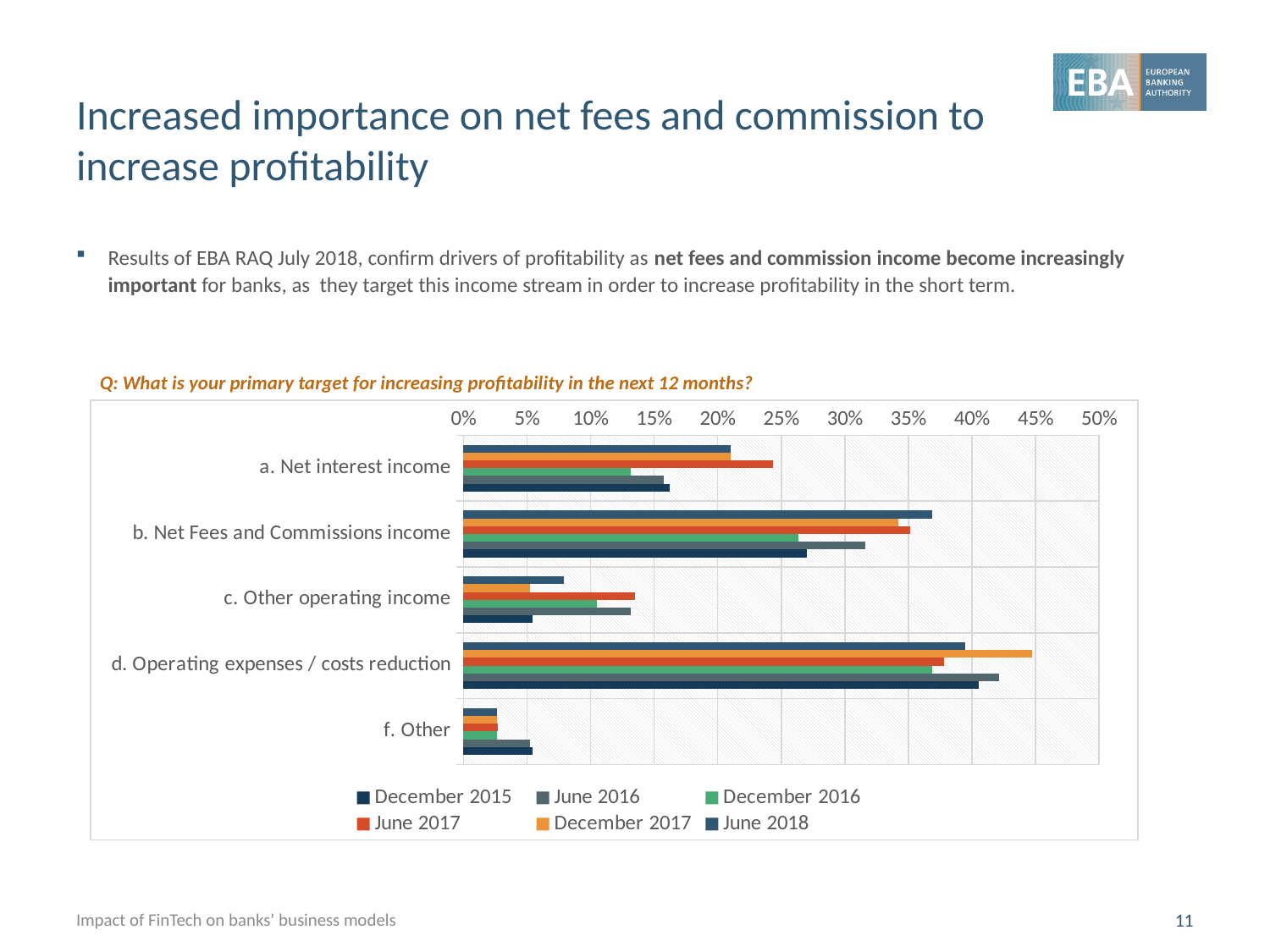
Are the values for f. Other greater or less than 10% for every series? less How many series does the chart legend list? 6 For the December 2017 series, which category has the larger value: b. Net Fees and Commissions income or d. Operating expenses / costs reduction? d. Operating expenses / costs reduction Which category has the shortest bars across all series? f. Other Are the values for c. Other operating income greater or less than 15% for every series? less Is the December 2017 value for d. Operating expenses / costs reduction greater or less than 40%? greater How many categories are shown on the chart's vertical axis? 5 What is the highest tick value shown on the chart's horizontal axis? 50% Which category has the longest bars across all series? d. Operating expenses / costs reduction What kind of chart is shown on the slide? bar chart For the December 2017 series, which category has the larger value: a. Net interest income or b. Net Fees and Commissions income? b. Net Fees and Commissions income